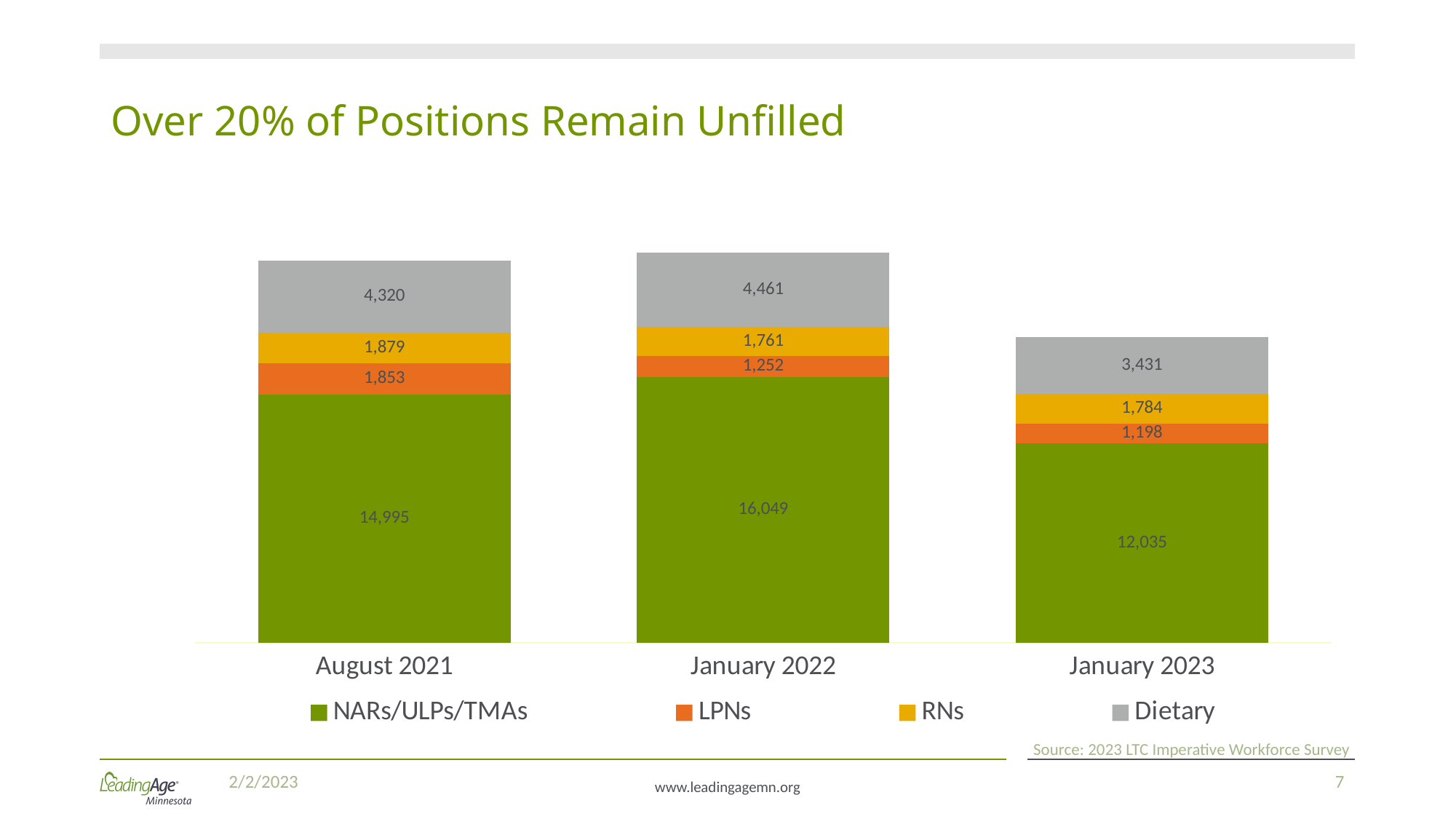
What is the difference between the NARs/ULPs/TMAs values for January 2022 and January 2023? 4,014 Which is larger, the Dietary value for August 2021 or for January 2022? January 2022 In which period is the NARs/ULPs/TMAs value highest? January 2022 How many series does the legend list? 4 What is the total of the stacked bar for January 2023? 18,448 What is the value for NARs/ULPs/TMAs in January 2022? 16,049 What kind of chart is shown on the slide? Stacked bar chart How many periods are shown on the x axis? 3 What is the LPNs value for August 2021? 1,853 What is the RNs value for January 2023? 1,784 In which period is the LPNs value lowest? January 2023 What is the Dietary value for January 2023? 3,431